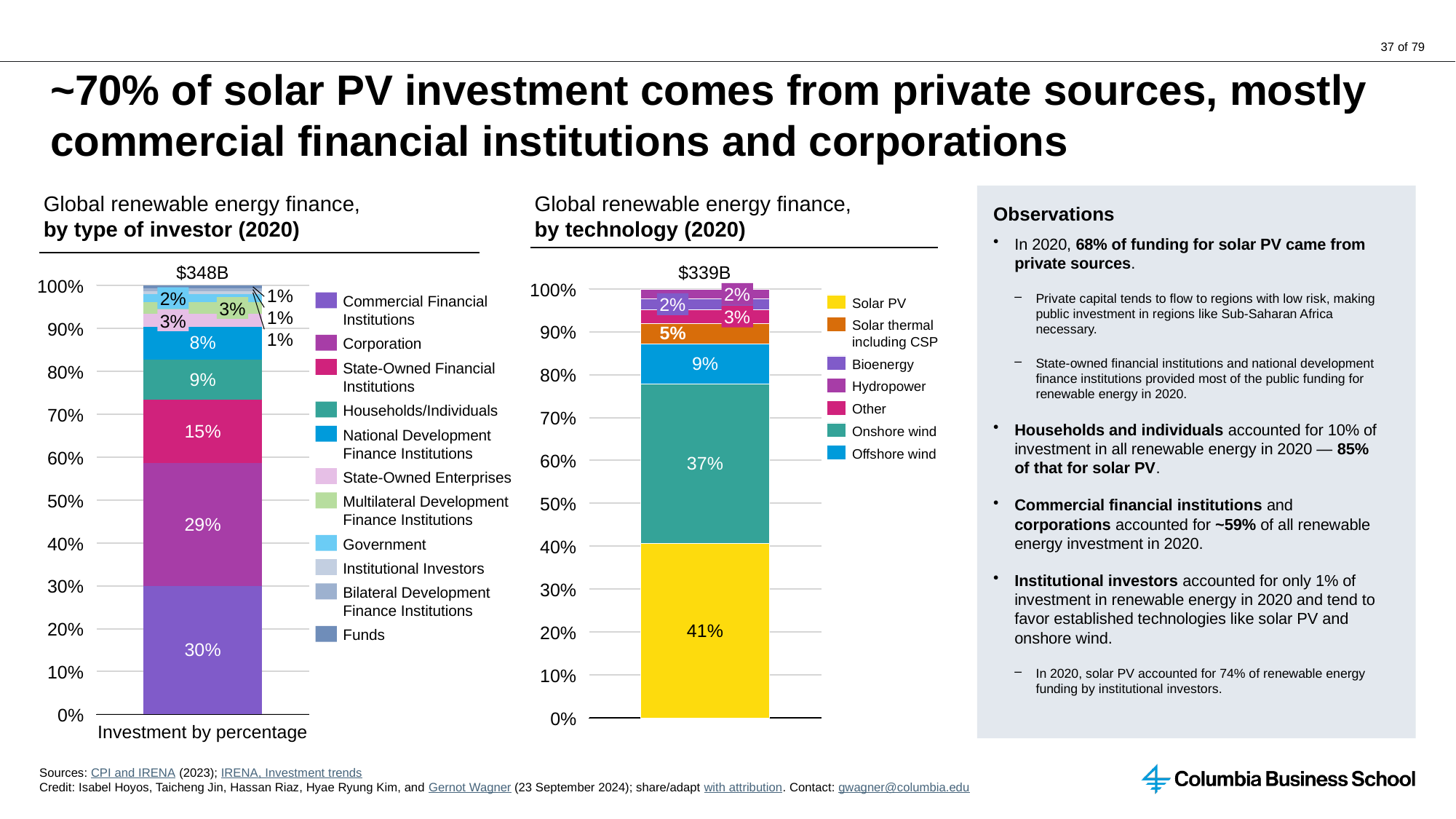
In the chart 'Global renewable energy finance, by type of investor (2020)', what percentage is shown for Corporation? 29% In the chart 'Global renewable energy finance, by technology (2020)', which technology has the largest share? Solar PV What total dollar amount is printed above the bar in the chart 'Global renewable energy finance, by type of investor (2020)'? $348B In the chart 'Global renewable energy finance, by type of investor (2020)', what percentage is shown for Commercial Financial Institutions? 30% In the chart 'Global renewable energy finance, by technology (2020)', what percentage is shown for Solar PV? 41% What kind of chart is 'Global renewable energy finance, by technology (2020)'? Stacked bar chart In the chart 'Global renewable energy finance, by type of investor (2020)', what is the difference in percentage points between State-Owned Financial Institutions and Households/Individuals? 6 percentage points In the chart 'Global renewable energy finance, by technology (2020)', what percentage is shown for Offshore wind? 9% How many series does the legend list in the chart 'Global renewable energy finance, by type of investor (2020)'? 11 How many series does the legend list in the chart 'Global renewable energy finance, by technology (2020)'? 7 In the chart 'Global renewable energy finance, by type of investor (2020)', what percentage is shown for State-Owned Financial Institutions? 15% In the chart 'Global renewable energy finance, by technology (2020)', what percentage is shown for Onshore wind? 37%